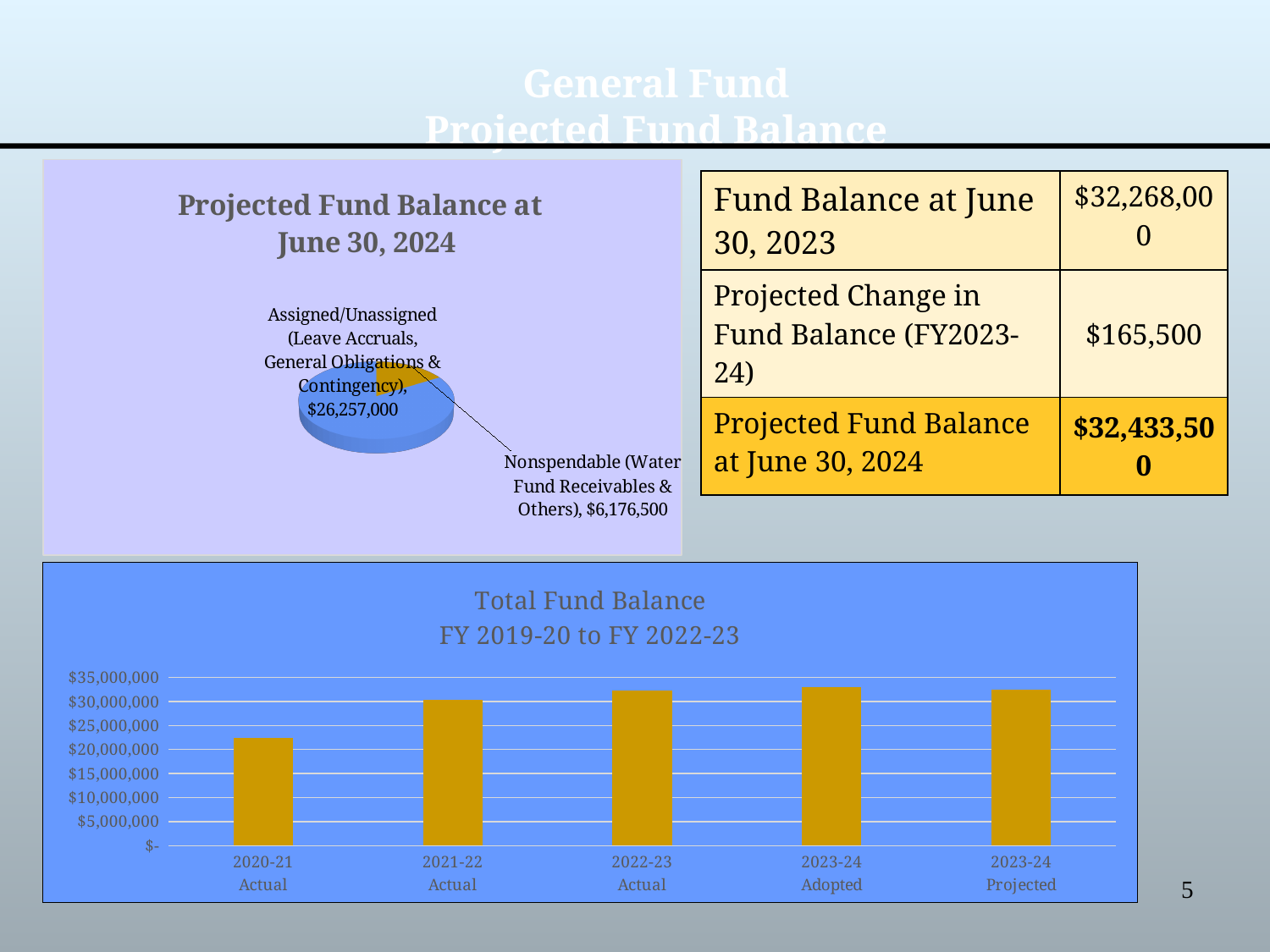
In the pie chart titled 'Projected Fund Balance at June 30, 2024', what is the difference between the Assigned/Unassigned slice and the Nonspendable slice? $20,080,500 In the bar chart titled 'Total Fund Balance FY 2019-20 to FY 2022-23', which category has the lowest value? 2020-21 Actual In the bar chart titled 'Total Fund Balance FY 2019-20 to FY 2022-23', which is larger, the value for 2020-21 Actual or the value for 2021-22 Actual? 2021-22 Actual In the pie chart titled 'Projected Fund Balance at June 30, 2024', what is the value of the Nonspendable (Water Fund Receivables & Others) slice? $6,176,500 In the bar chart titled 'Total Fund Balance FY 2019-20 to FY 2022-23', is the value for 2020-21 Actual greater or less than $25,000,000? less What kind of chart is the 'Total Fund Balance FY 2019-20 to FY 2022-23' chart at the bottom of the slide? bar chart In the pie chart titled 'Projected Fund Balance at June 30, 2024', which slice is larger? Assigned/Unassigned (Leave Accruals, General Obligations & Contingency) In the pie chart titled 'Projected Fund Balance at June 30, 2024', what is the value of the Assigned/Unassigned (Leave Accruals, General Obligations & Contingency) slice? $26,257,000 In the pie chart titled 'Projected Fund Balance at June 30, 2024', how many slices are there? 2 In the bar chart titled 'Total Fund Balance FY 2019-20 to FY 2022-23', is the value for 2023-24 Adopted greater or less than $30,000,000? greater In the bar chart titled 'Total Fund Balance FY 2019-20 to FY 2022-23', how many bars are there? 5 In the pie chart titled 'Projected Fund Balance at June 30, 2024', what is the total of the two slices? $32,433,500